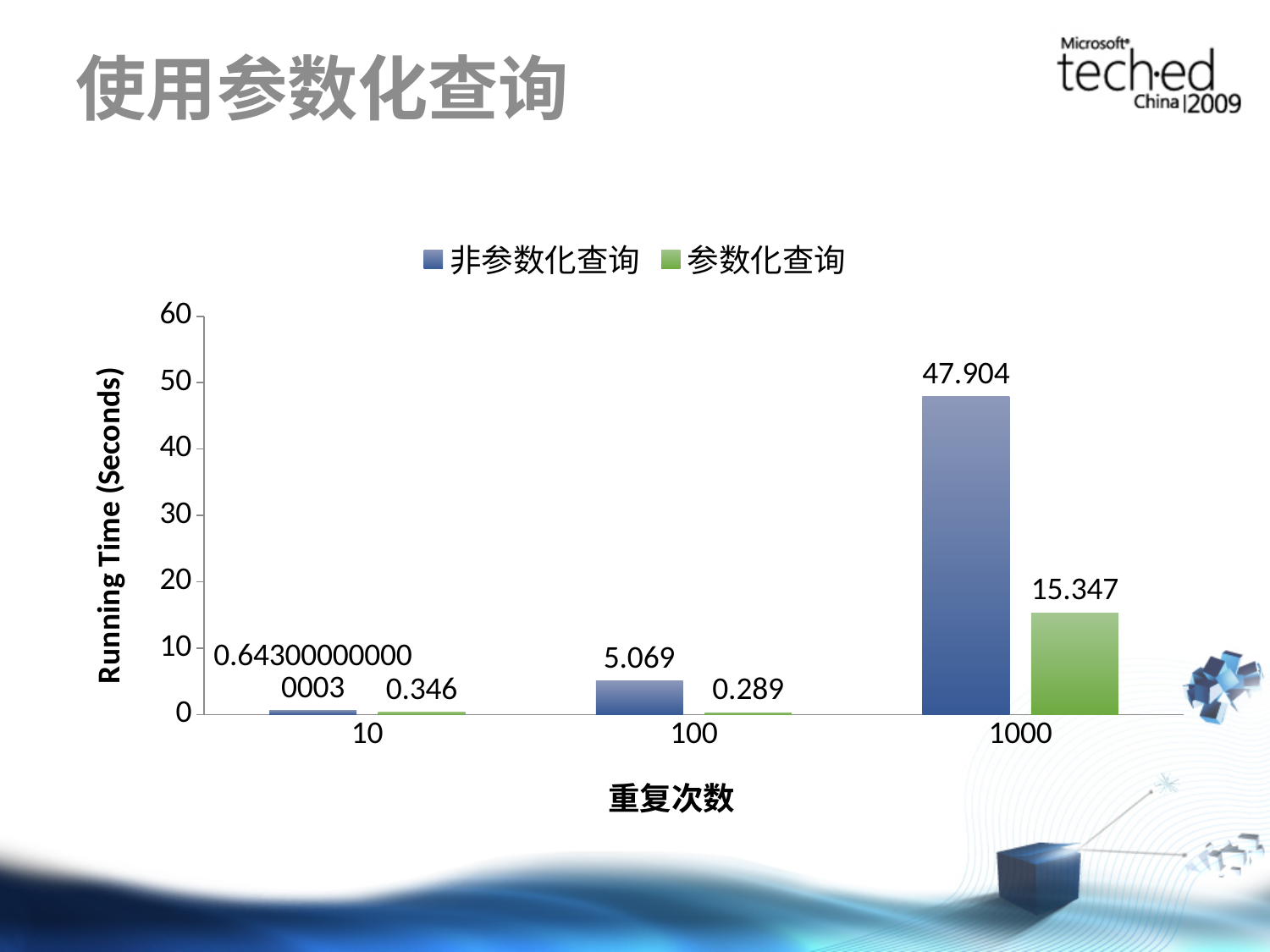
What is the difference between 非参数化查询 and 参数化查询 at 1000 repetitions? 32.557 What is the running time for 参数化查询 at 100 repetitions? 0.289 What is the label of the y axis? Running Time (Seconds) What is the running time for 非参数化查询 at 1000 repetitions? 47.904 How many series does the legend list? 2 Which category has the highest value for 非参数化查询? 1000 What is the running time for 非参数化查询 at 100 repetitions? 5.069 What type of chart is shown on the slide? bar chart How many categories are shown on the x axis? 3 What is the running time for 参数化查询 at 10 repetitions? 0.346 At 100 repetitions, which series has the larger value, 非参数化查询 or 参数化查询? 非参数化查询 What is the running time for 参数化查询 at 1000 repetitions? 15.347